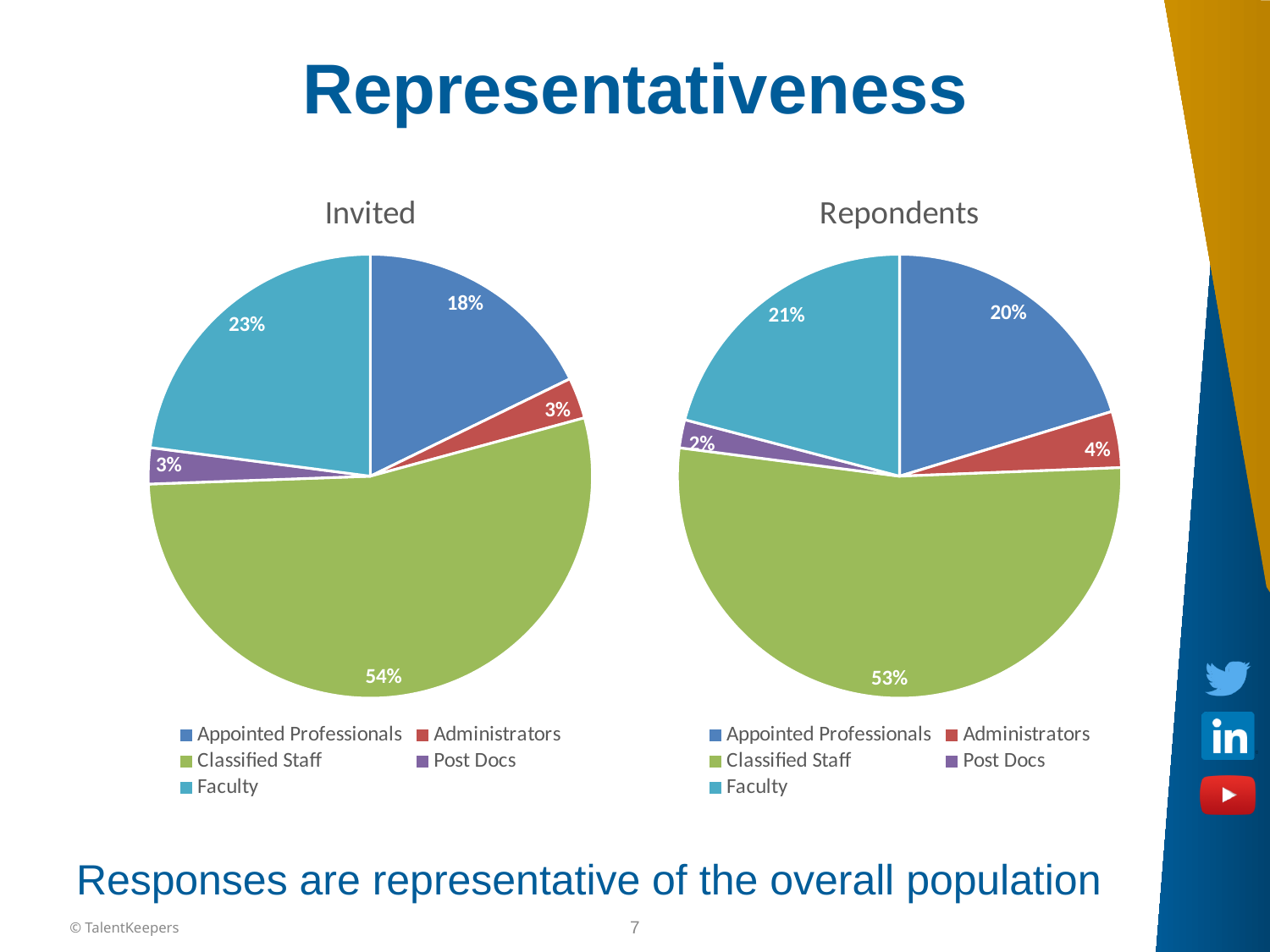
In the "Repondents" pie chart, what share does Post Docs have? 2% In the "Repondents" pie chart, which category has the largest slice? Classified Staff What is the difference between the Faculty share in the "Invited" chart and the Faculty share in the "Repondents" chart? 2% In the "Invited" pie chart, what share does Classified Staff have? 54% In the "Repondents" pie chart, which category has the smallest slice? Post Docs In the "Invited" pie chart, which category has the largest slice? Classified Staff What type of chart is used for "Invited"? Pie chart In the "Repondents" pie chart, what colour is the Administrators slice? Red In the "Invited" pie chart, what share does Appointed Professionals have? 18% Which is larger: the Appointed Professionals share in the "Invited" chart or in the "Repondents" chart? Repondents In the "Repondents" pie chart, what share does Faculty have? 21% How many categories does the "Invited" pie chart show? 5